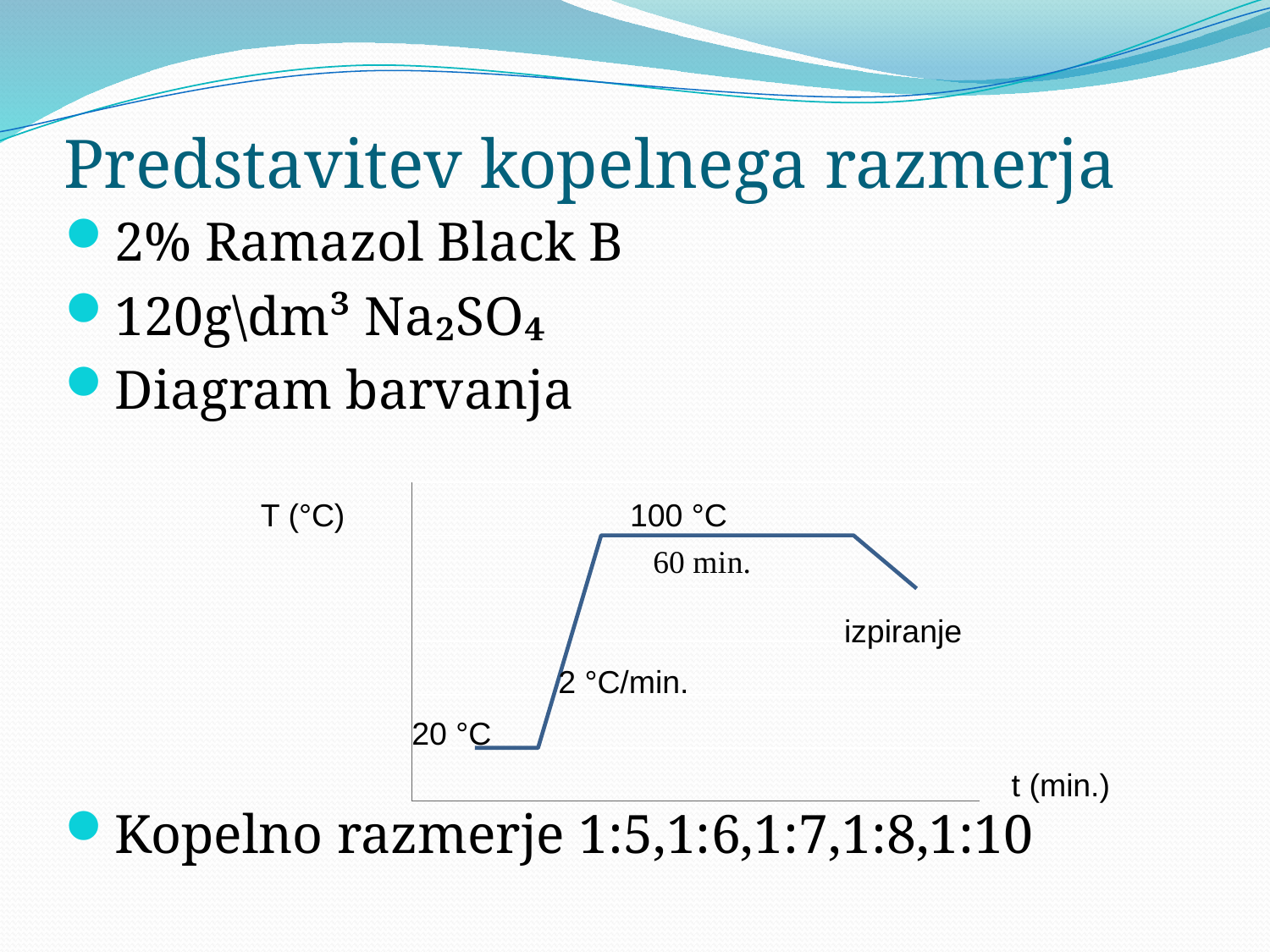
What is the difference between the plateau temperature and the starting temperature on the diagram? 80 °C Which is higher on the diagram, the starting temperature or the plateau temperature? plateau temperature (100 °C) What heating rate is labelled on the rising segment of the diagram? 2 °C/min. What process is labelled on the final descending segment of the diagram? izpiranje What is the highest temperature reached on the dyeing diagram? 100 °C What kind of chart is the diagram on the slide? line chart What is the starting temperature shown on the dyeing diagram? 20 °C What is the label on the vertical axis of the diagram? T (°C) What is the lowest temperature labelled on the dyeing diagram? 20 °C What is the label on the horizontal axis of the diagram? t (min.) How long is the temperature held at 100 °C according to the diagram? 60 min. Does the temperature rise or fall along the first sloped segment of the diagram? rise